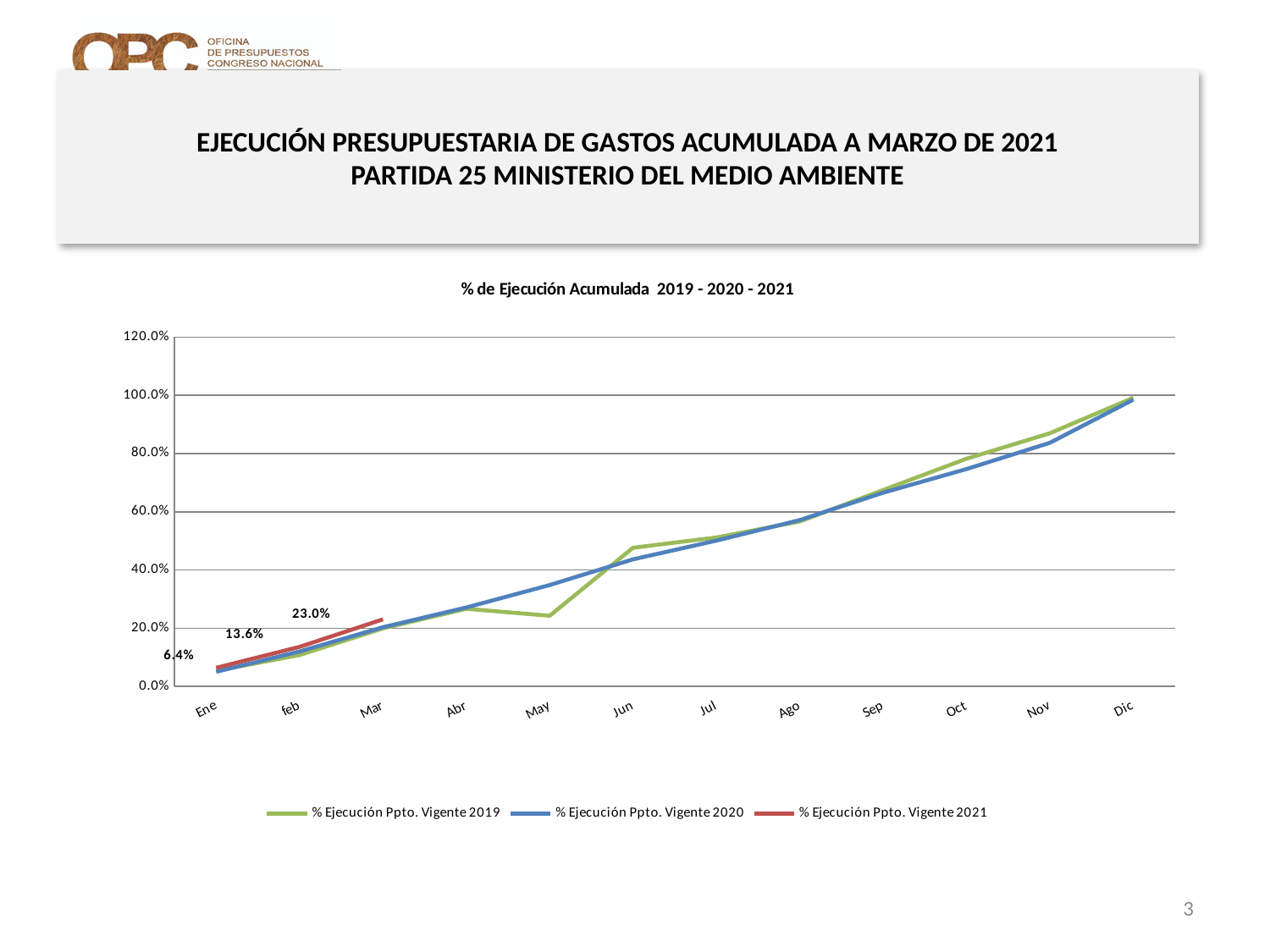
What is the difference between the feb and Ene values of the % Ejecución Ppto. Vigente 2021 series? 7.2% In May, which series has the larger value: % Ejecución Ppto. Vigente 2019 or % Ejecución Ppto. Vigente 2020? % Ejecución Ppto. Vigente 2020 What is the value for Ene in the % Ejecución Ppto. Vigente 2021 series? 6.4% What is the value for feb in the % Ejecución Ppto. Vigente 2021 series? 13.6% Do the values of the % Ejecución Ppto. Vigente 2021 series rise or fall from Ene to Mar? Rise What kind of chart is shown on the slide? Line chart How many months are shown on the x axis? 12 What is the difference between the Mar and feb values of the % Ejecución Ppto. Vigente 2021 series? 9.4% What is the title of the chart? % de Ejecución Acumulada 2019 - 2020 - 2021 What is the value for Mar in the % Ejecución Ppto. Vigente 2021 series? 23.0% Is the value for Dic in the % Ejecución Ppto. Vigente 2020 series greater or less than 80.0%? greater How many series does the legend list? 3